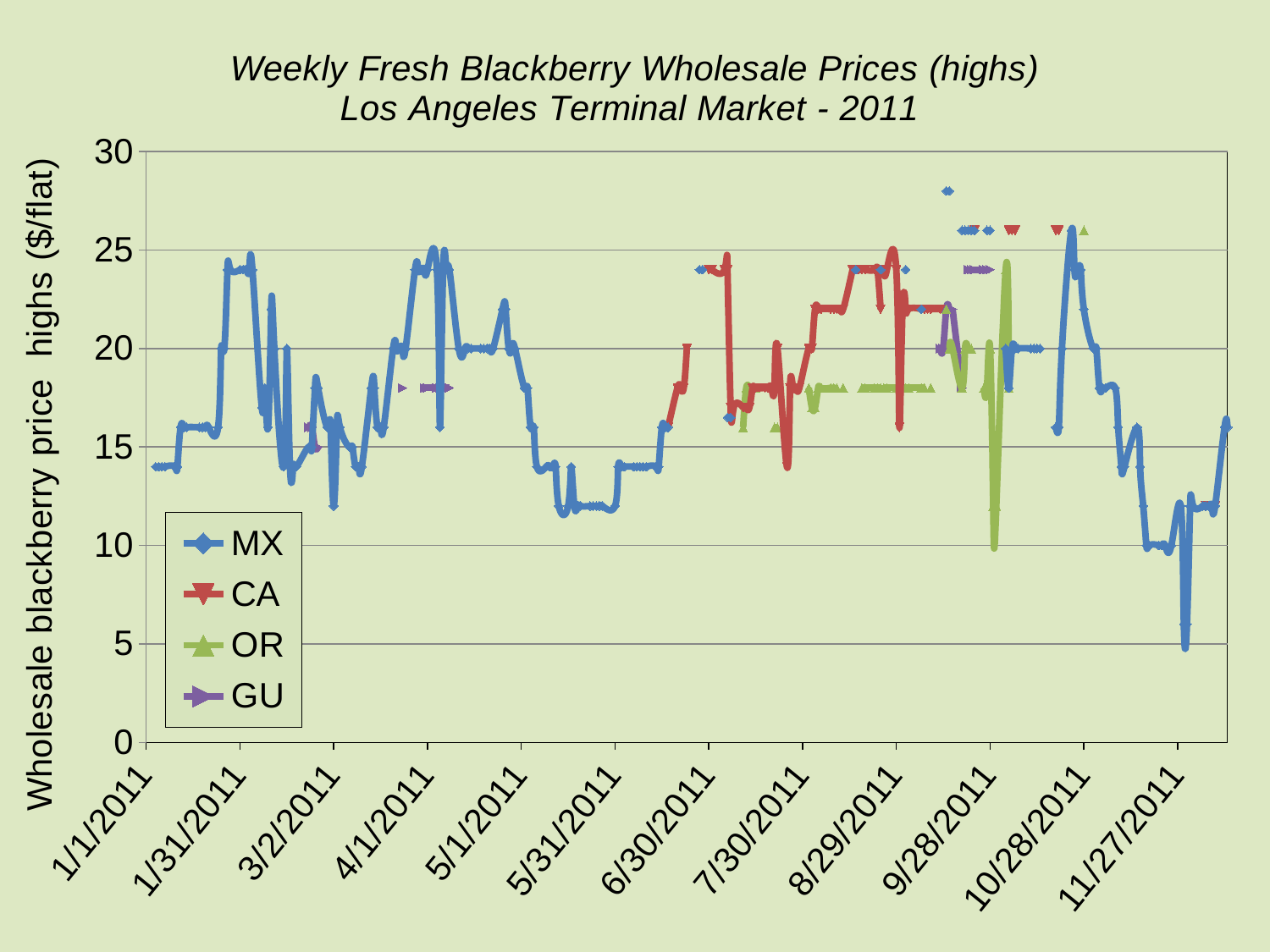
Which series reaches the lowest value on the chart? MX What is the label on the vertical axis? Wholesale blackberry price highs ($/flat) Which series reaches the highest value on the chart? MX Is the GU value near 4/1/2011 greater or less than 15? greater Does the MX series rise or fall between 10/28/2011 and 11/27/2011? fall How many date labels are shown on the horizontal axis? 12 Is the MX value at 1/1/2011 greater or less than 20? less How many series does the legend list? 4 Is the lowest MX value near 11/27/2011 greater or less than 10? less What kind of chart is shown on the slide? line chart What is the title of the chart? Weekly Fresh Blackberry Wholesale Prices (highs) Los Angeles Terminal Market - 2011